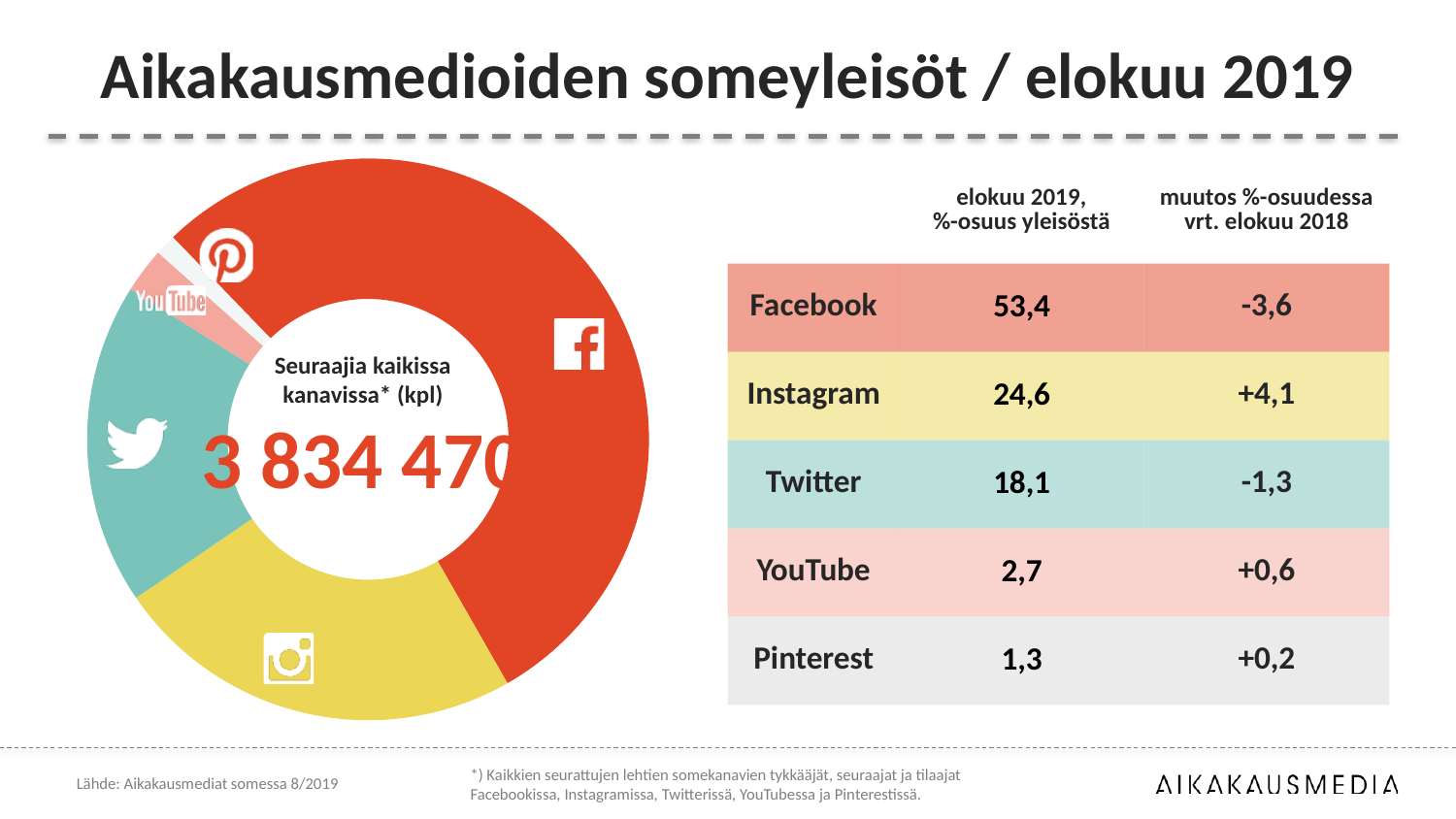
According to the table, what is Facebook's %-share of the audience in August 2019? 53,4 According to the table, what is Instagram's %-share of the audience in August 2019? 24,6 How many social media channels are shown as slices in the donut chart? 5 Which channel has the largest share of the audience in the donut chart? Facebook Which channel has the smallest share of the audience in the donut chart? Pinterest What is the difference in %-share between Facebook and Instagram in August 2019? 28,8 Which has a larger %-share of the audience, Twitter or YouTube? Twitter According to the table, what is Twitter's %-share of the audience in August 2019? 18,1 What is the total number of followers across all channels shown in the centre of the donut chart? 3 834 470 What is the change in %-share for Instagram compared with August 2018? +4,1 What is the change in %-share for Facebook compared with August 2018? -3,6 What kind of chart is shown on the left of the slide? Donut (pie) chart